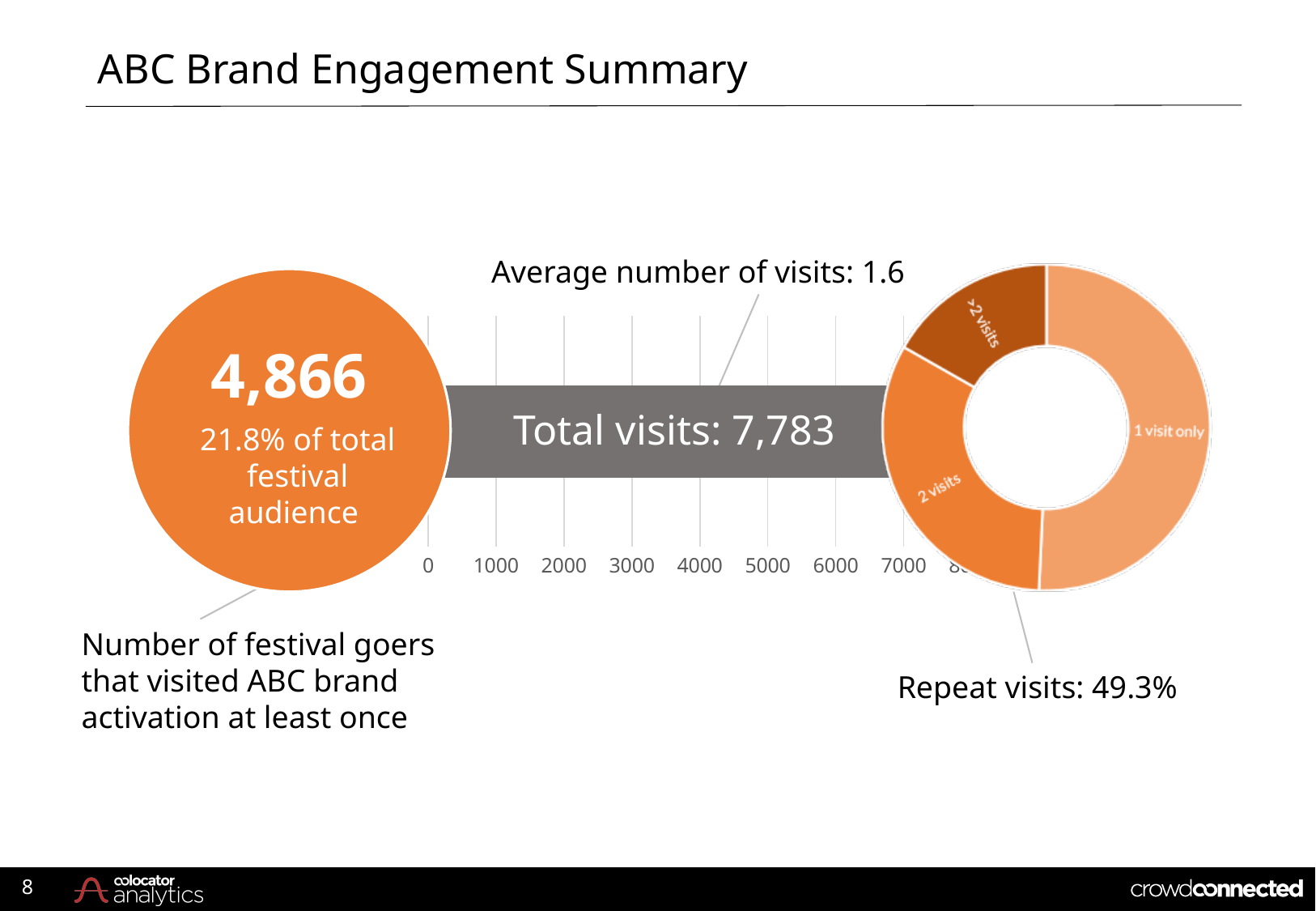
According to the annotation on the doughnut chart on the right of the slide, what percentage of visits are repeat visits? 49.3% On the doughnut chart on the right of the slide, which slice is larger: 2 visits or >2 visits? 2 visits How many bars are plotted on the bar chart in the middle of the slide? 1 On the bar chart in the middle of the slide, is the value of the total visits bar greater or less than 7000? greater How many slices does the doughnut chart on the right of the slide have? 3 What is the average number of visits stated above the bar chart in the middle of the slide? 1.6 On the bar chart in the middle of the slide, what is the total number of visits shown on the bar? 7,783 On the doughnut chart on the right of the slide, which slice is the smallest? >2 visits What kind of chart is the chart on the right of the slide? doughnut chart On the doughnut chart on the right of the slide, which slice is the largest? 1 visit only What kind of chart is the chart in the middle of the slide with the axis from 0 to 8000? bar chart What is the title of the slide? ABC Brand Engagement Summary